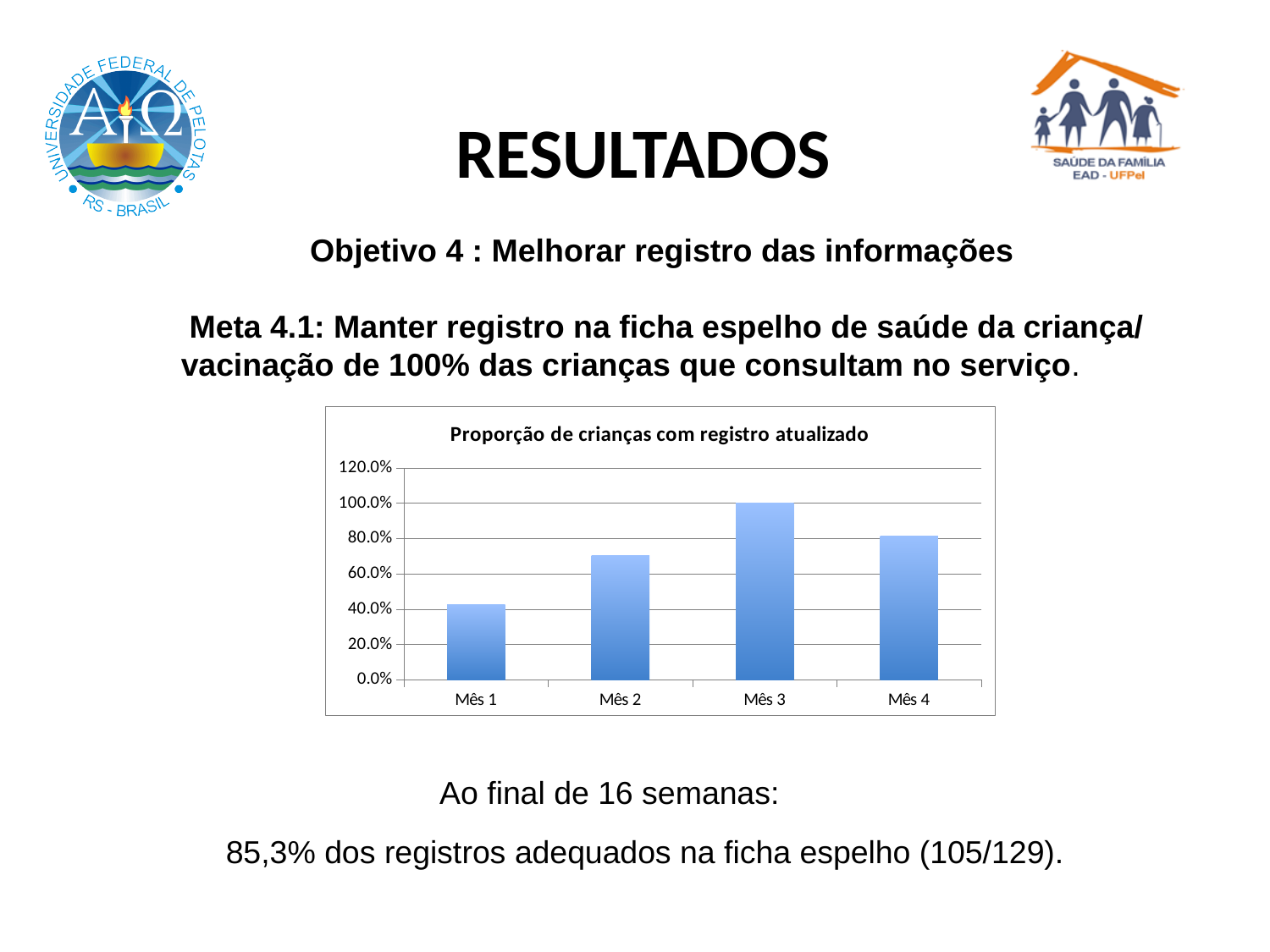
What kind of chart is shown on the slide? bar chart Is the value for Mês 1 greater or less than 60.0%? less What is the title of the chart? Proporção de crianças com registro atualizado What is the value for Mês 3? 100.0% Which is larger, the value for Mês 2 or the value for Mês 4? Mês 4 Do the values rise or fall from Mês 1 to Mês 3? rise How many months (categories) are plotted in the chart? 4 Which month has the highest proportion of children with updated records? Mês 3 What is the highest value shown on the vertical axis? 120.0% Is the value for Mês 2 greater or less than 60.0%? greater Which month has the lowest proportion of children with updated records? Mês 1